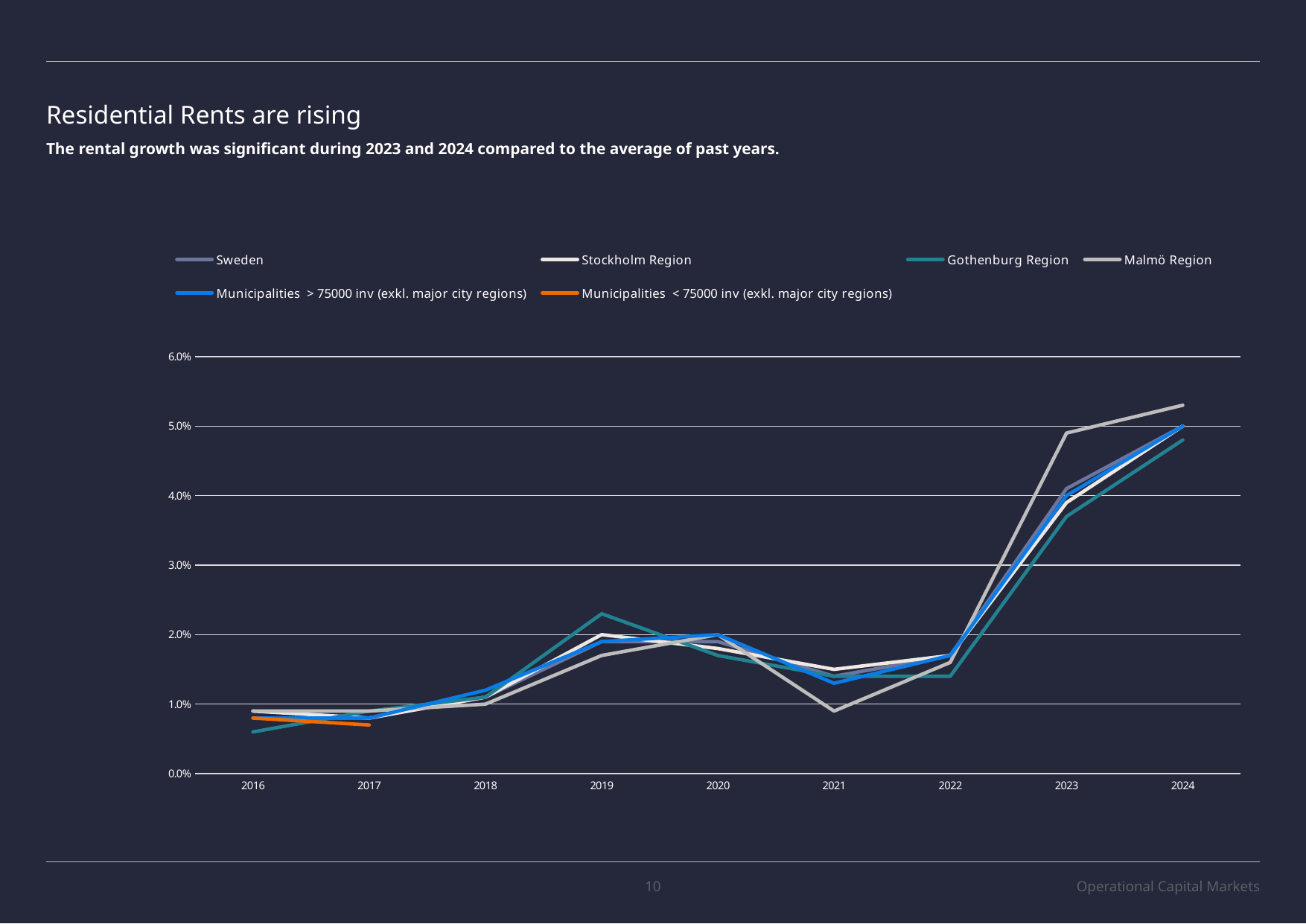
How many years are shown on the x axis of the chart? 9 In which year does the Malmö Region series reach its highest value? 2024 Is the value for Gothenburg Region in 2019 greater or less than 2.0%? greater Is the value for Sweden in 2024 greater or less than 4.0%? greater What kind of chart is shown on the slide? line chart Is the value for Malmö Region in 2021 greater or less than 2.0%? less In 2023, which is larger: the value for Malmö Region or the value for Gothenburg Region? Malmö Region Which series in the legend is drawn in orange? Municipalities < 75000 inv (exkl. major city regions) In which year does the Gothenburg Region series have its lowest value? 2016 How many series does the chart legend list? 6 Do the values for Sweden rise or fall from 2022 to 2024? rise